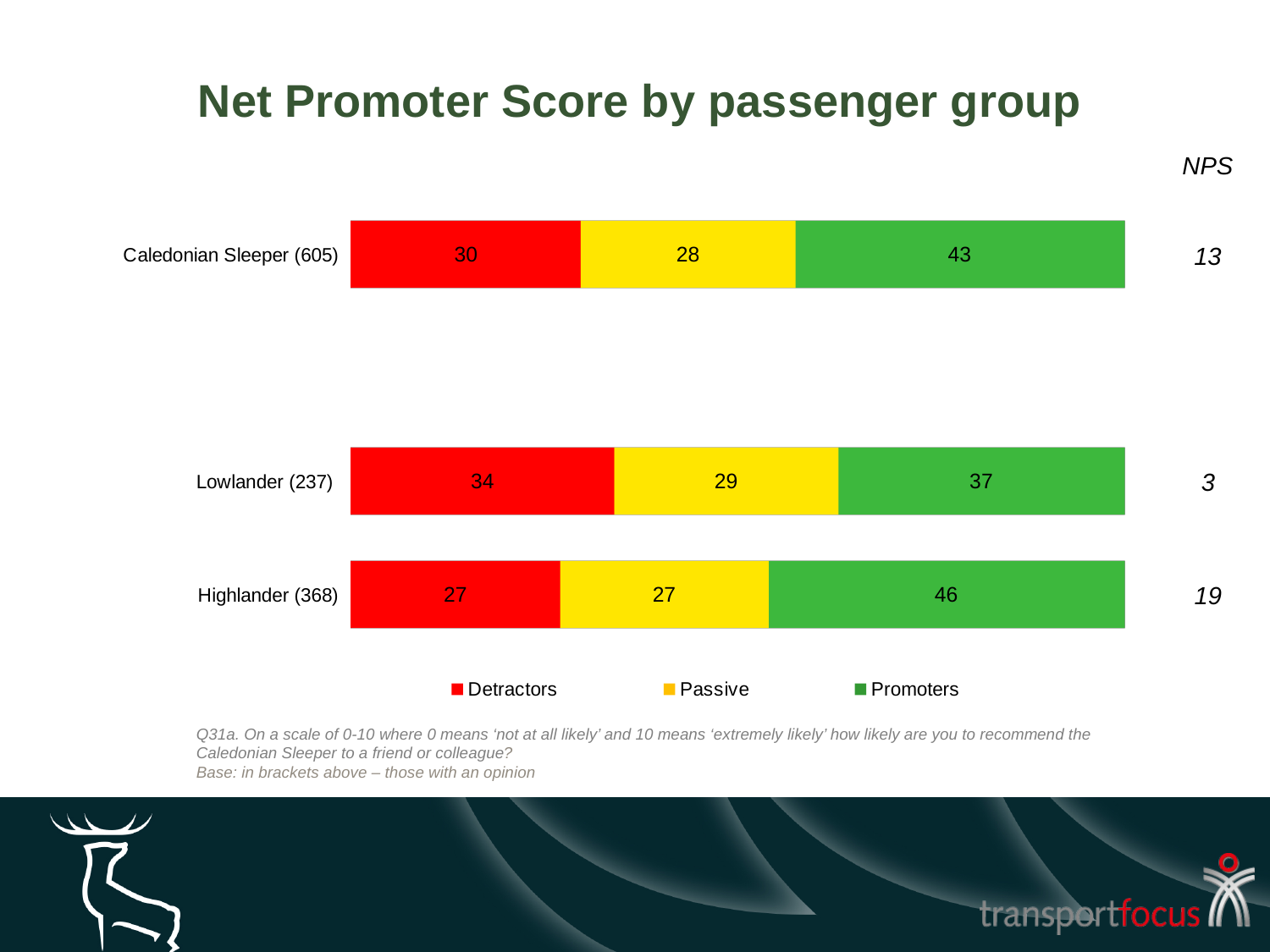
What is the Detractors value for Lowlander (237)? 34 Which passenger group has the lowest Detractors value? Highlander (368) What is the difference between the Promoters values for Highlander (368) and Lowlander (237)? 9 Which colour represents Promoters in the chart? Green How many series does the legend list? 3 Which is larger, the Detractors value for Lowlander (237) or for Caledonian Sleeper (605)? Lowlander (237) How many passenger groups are shown in the chart? 3 What is the NPS shown for Highlander (368)? 19 What is the Passive value for Highlander (368)? 27 What kind of chart is shown on the slide? Stacked bar chart What is the Promoters value for Caledonian Sleeper (605)? 43 Which passenger group has the highest Promoters value? Highlander (368)